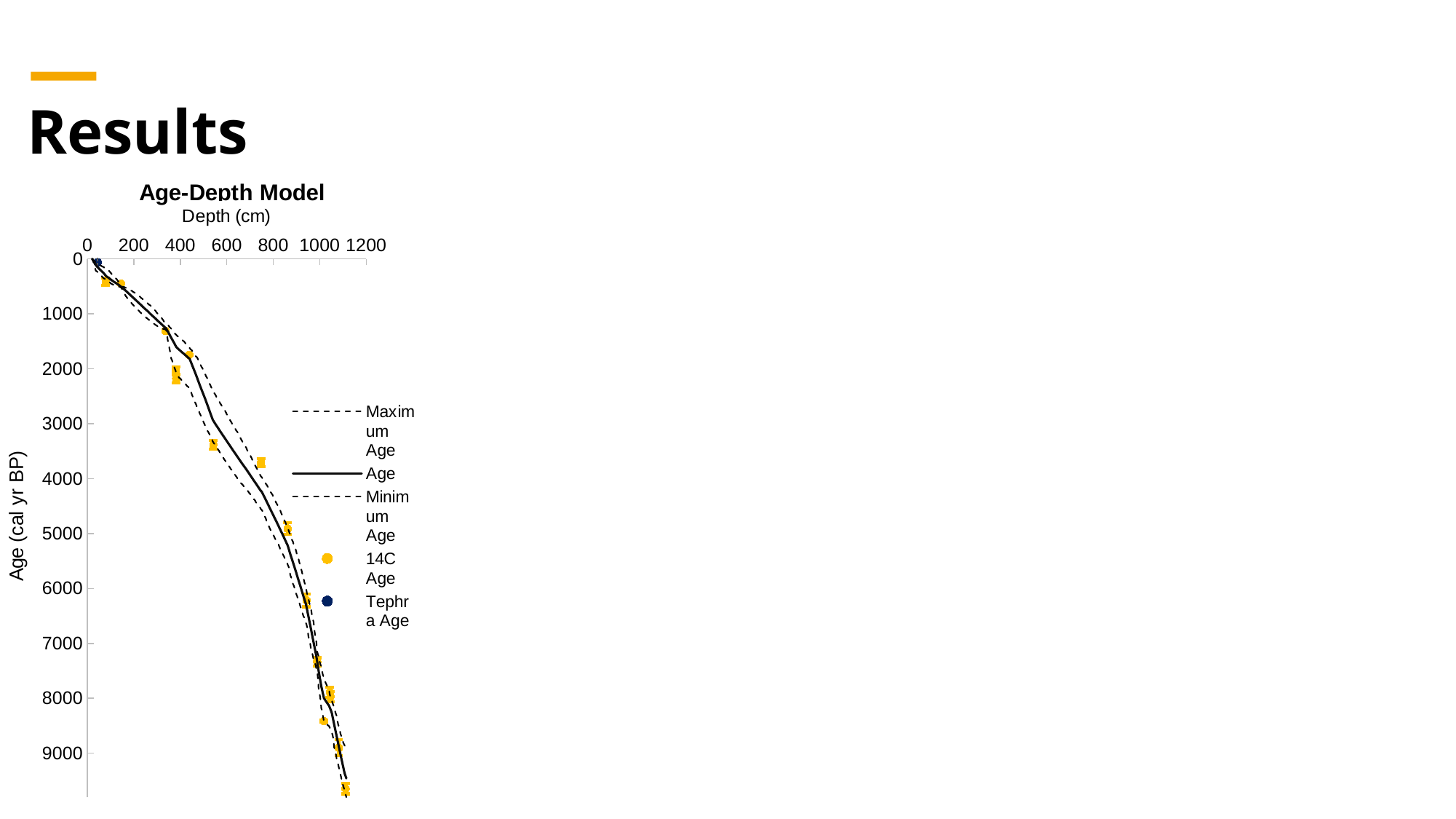
In the Age-Depth Model chart, is the age of the 14C Age point at about 750 cm depth greater or less than 4000 cal yr BP? less What kind of chart is the Age-Depth Model? Line chart with scatter points What is the label of the horizontal axis of the Age-Depth Model chart? Depth (cm) In the Age-Depth Model chart, is the age of the 14C Age point at about 540 cm depth greater or less than 3000 cal yr BP? greater In the Age-Depth Model chart, is the age of the deepest 14C Age point (around 1100 cm) greater or less than 9000 cal yr BP? greater What is the title of the chart on the slide? Age-Depth Model What is the maximum value shown on the Depth (cm) axis of the Age-Depth Model chart? 1200 How many series does the legend of the Age-Depth Model chart list? 5 In the Age-Depth Model chart, does age rise or fall as depth increases? Rise